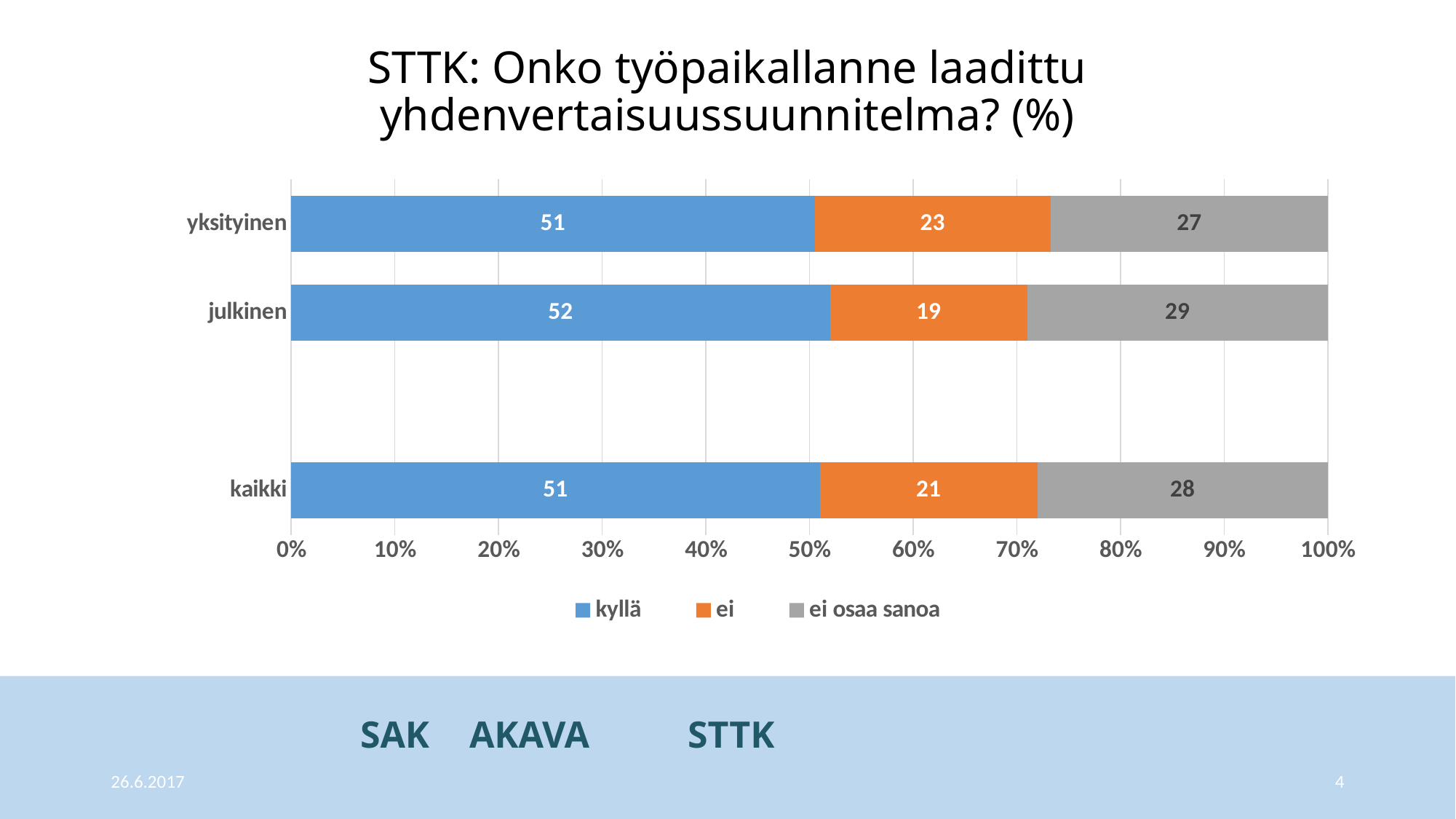
Which category has the highest value for "ei"? yksityinen What is the value for "ei" in the "julkinen" category? 19 Which is larger: the "ei osaa sanoa" value for "julkinen" or for "kaikki"? julkinen Which colour represents the "ei" series in the chart? orange What is the value for "kyllä" in the "yksityinen" category? 51 What is the value for "ei osaa sanoa" in the "kaikki" category? 28 What is the difference between the "ei" values for "yksityinen" and "julkinen"? 4 Which category has the lowest value for "ei osaa sanoa"? yksityinen What kind of chart is shown on the slide? stacked bar chart How many categories are shown on the chart? 3 How many series does the legend list? 3 What is the total of the stacked bar for "yksityinen"? 101